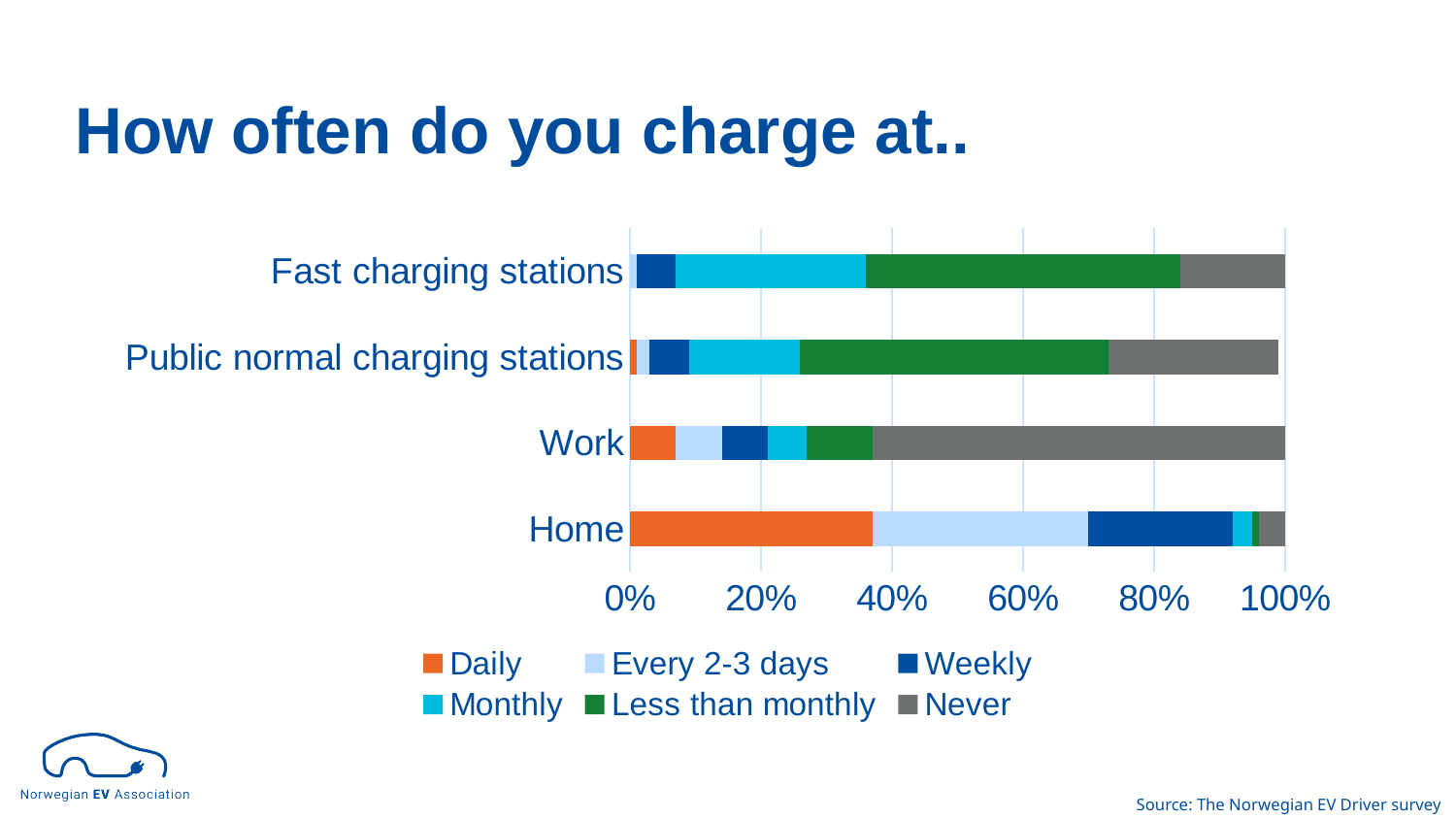
Which is larger: the 'Never' share for Work or the 'Never' share for Home? Work Which colour represents 'Daily' in the legend? Orange Which charging location has the largest 'Never' segment? Work How many series does the legend list? 6 Is the 'Daily' share for Home greater or less than 20%? greater Is the 'Never' share for Home greater or less than 20%? less What kind of chart is shown on the slide? Stacked bar chart Is the 'Daily' share for Work greater or less than 20%? less How many charging locations (categories) are shown on the chart? 4 Which charging location has the largest 'Daily' segment? Home What is the title of the chart on the slide? How often do you charge at..